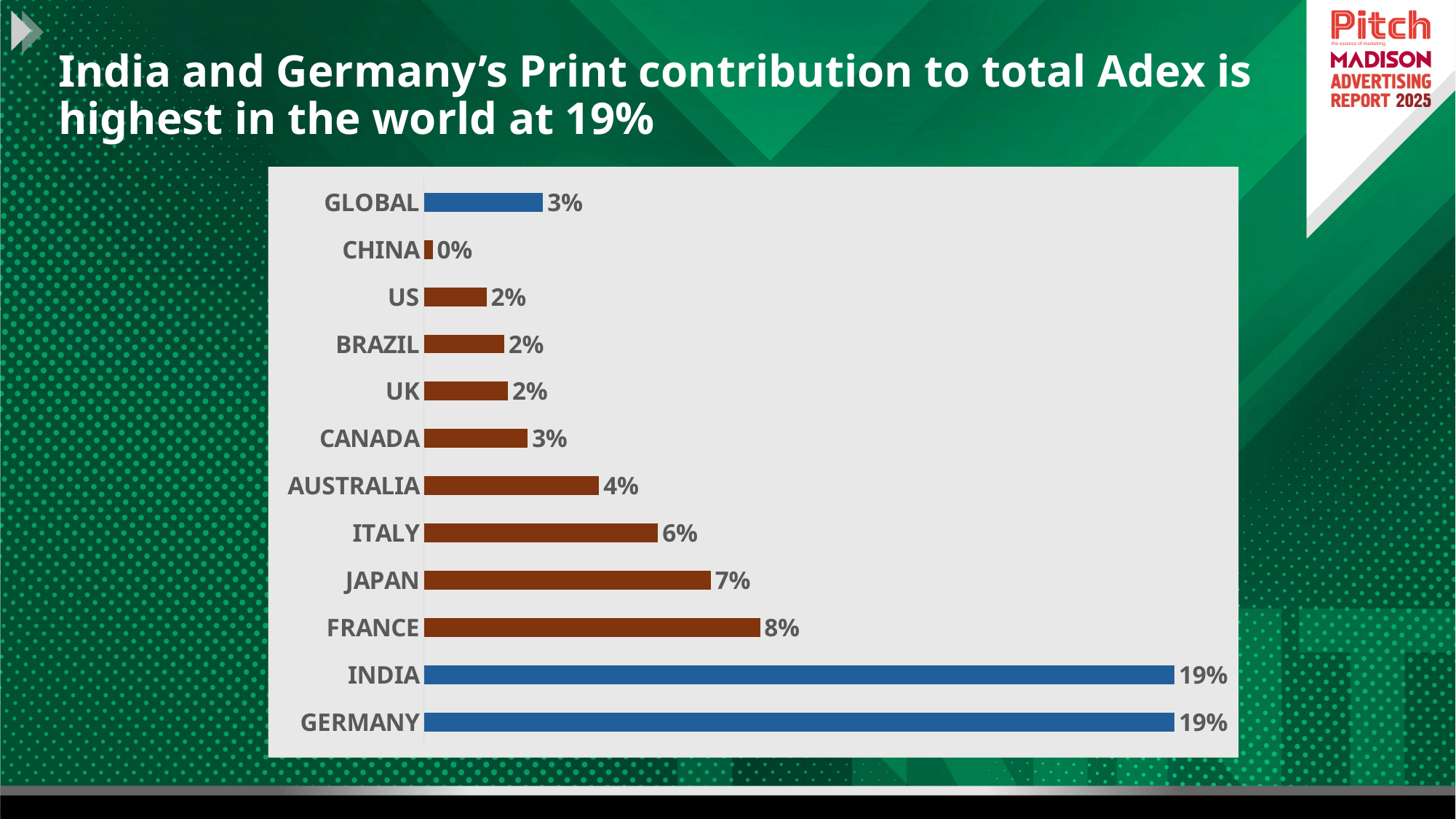
What kind of chart is shown on the slide? Bar chart What is the Print contribution value shown for France? 8% Which is larger, the value for Japan or the value for Australia? Japan What is the value shown for Australia? 4% What is the difference between the values for India and France? 11% How many categories are plotted on the chart? 12 What is the value shown for Japan? 7% What is the difference between the values for Italy and Canada? 3% Which bars are coloured blue rather than brown? Global, India and Germany What is the value shown for Global? 3% Which is larger, the value for Italy or the value for France? France Which category has the lowest value on the chart? China